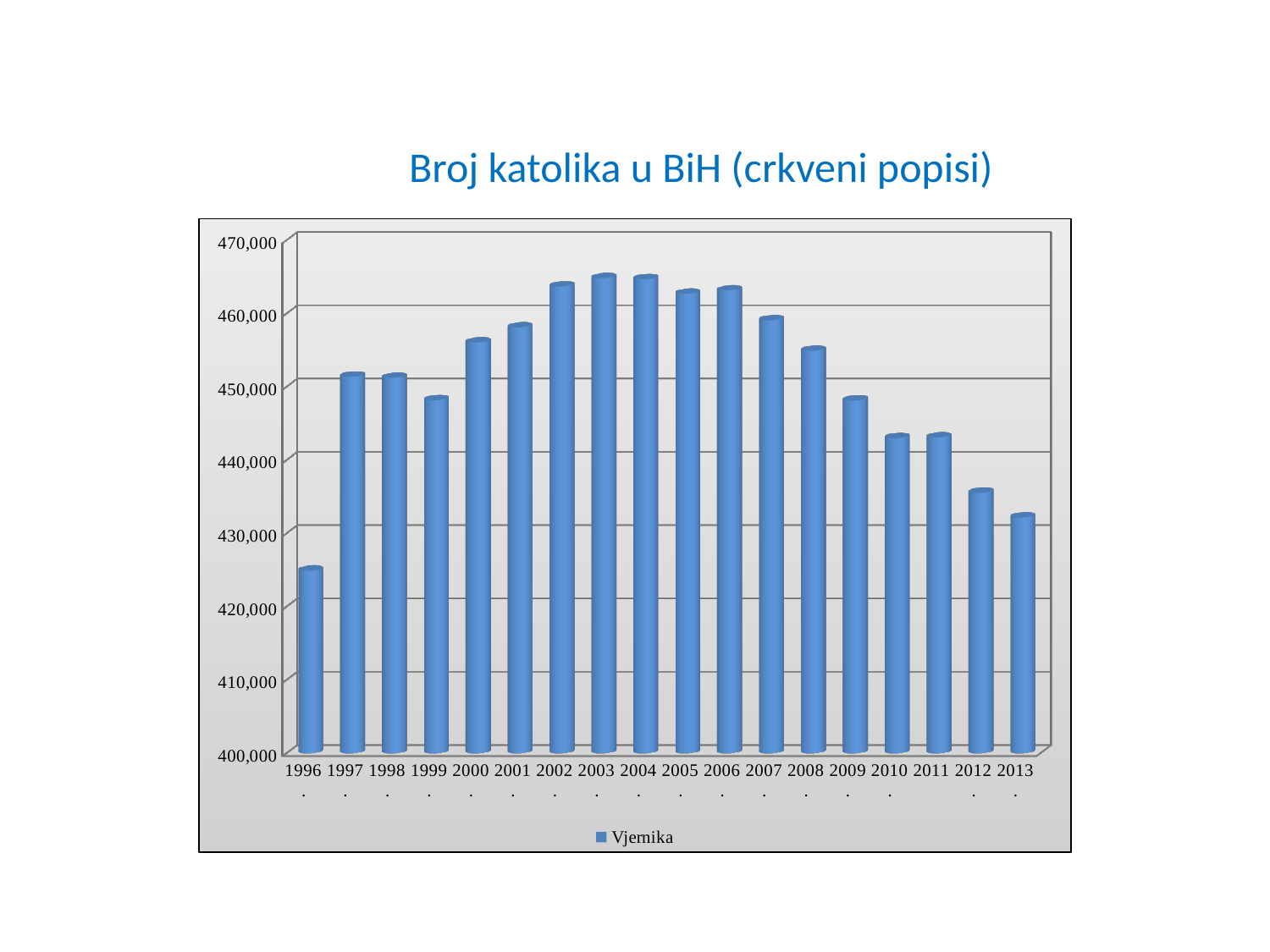
Is the value for 2012 greater or less than 440,000? less Is the value for 1996 greater or less than 430,000? less Which is larger, the value for 2007 or the value for 2012? 2007 Is the value for 2013 greater or less than 430,000? greater What is the name of the series shown in the legend? Vjernika What kind of chart is shown on the slide? bar chart How many years are plotted on the x axis? 18 Which year has the lowest value? 1996 How many series does the legend list? 1 Do the values rise or fall from 2004 to 2013? fall What is the title of the chart? Broj katolika u BiH (crkveni popisi)